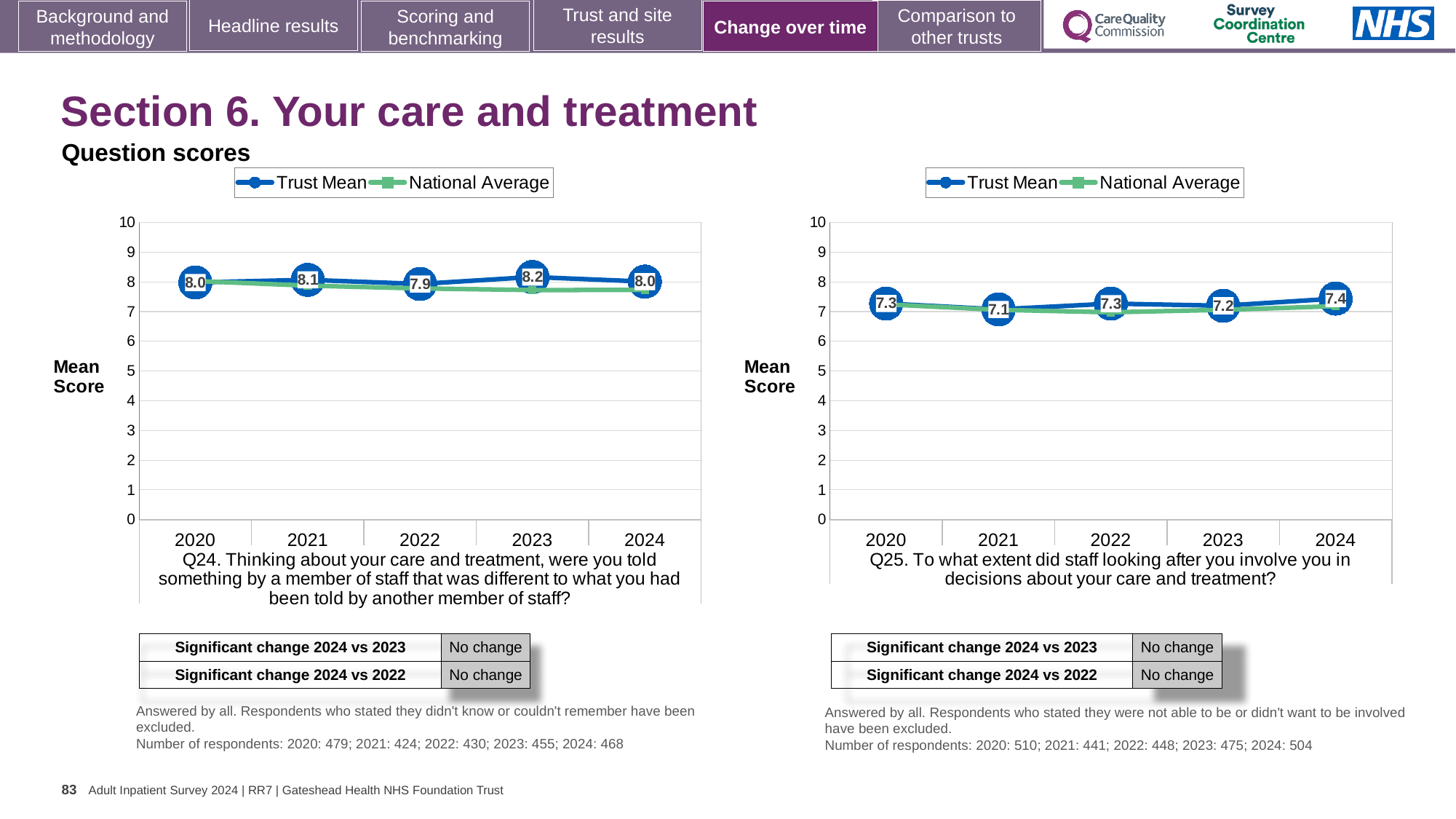
In the left chart (Q24), what is the Trust Mean score for 2023? 8.2 In the right chart (Q25), is the Trust Mean score for 2024 larger or smaller than the score for 2020? larger In the left chart (Q24), what is the difference between the Trust Mean scores for 2023 and 2022? 0.3 In the left chart (Q24), is the National Average value for 2024 greater or less than 8? less What kind of chart is the right chart (Q25)? line chart In the right chart (Q25), what is the Trust Mean score for 2021? 7.1 How many series does the legend of the left chart (Q24) list? 2 In the left chart (Q24), which year has the highest Trust Mean score? 2023 In the left chart (Q24), which year has the lowest Trust Mean score? 2022 In the right chart (Q25), which year has the highest Trust Mean score? 2024 How many years are plotted on the x axis of the right chart (Q25)? 5 In the right chart (Q25), which year has the lowest Trust Mean score? 2021